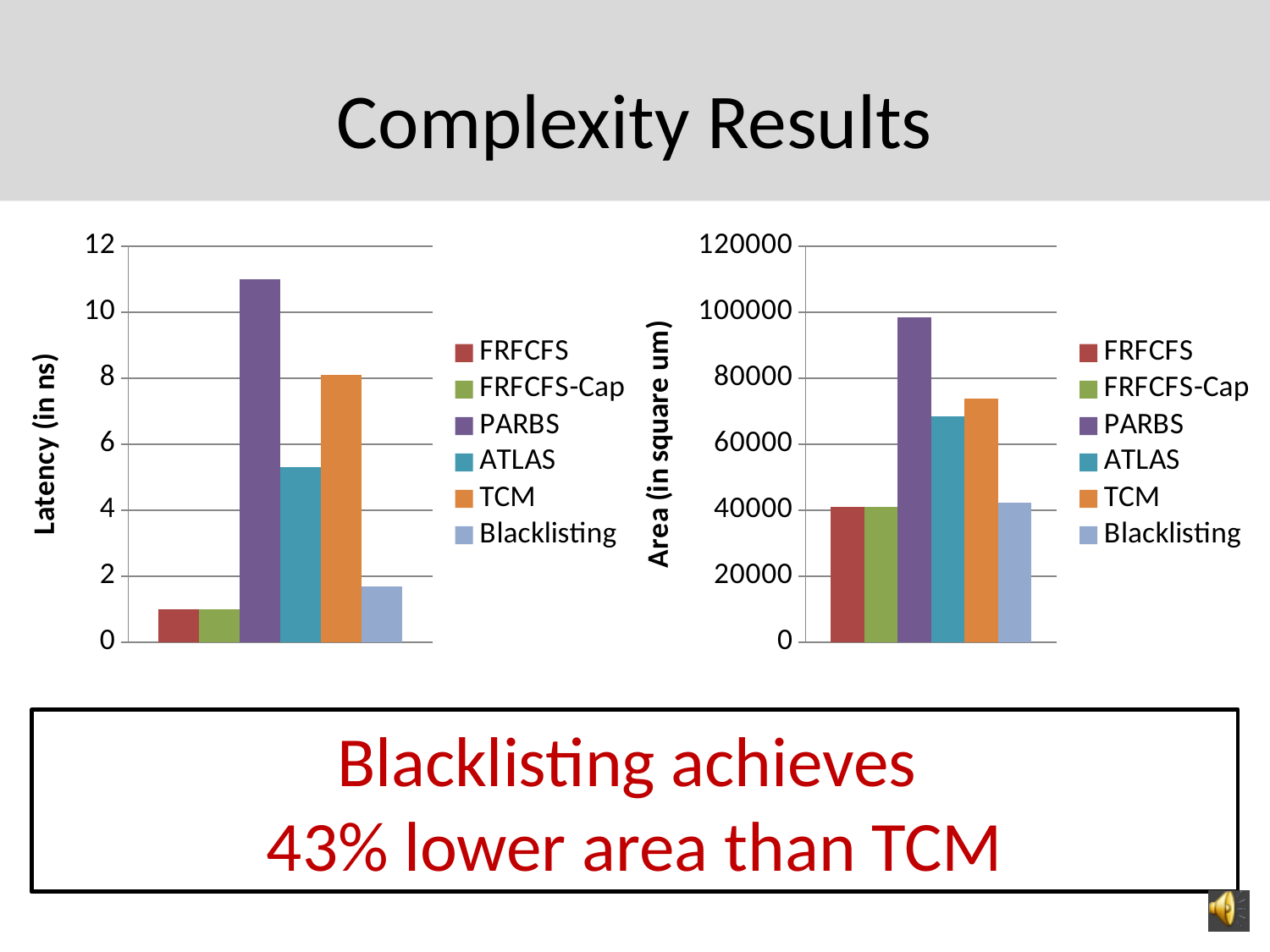
In the right chart (Area in square um), which has the larger area, TCM or ATLAS? TCM How many series does the legend of the right chart (Area in square um) list? 6 In the right chart (Area in square um), which series has the largest area? PARBS In the left chart (Latency in ns), which series has the highest latency? PARBS In the left chart (Latency in ns), is the value for PARBS greater or less than 10? greater In the left chart (Latency in ns), which has the higher latency, Blacklisting or ATLAS? ATLAS In the right chart (Area in square um), is the value for Blacklisting greater or less than 60000? less In the right chart (Area in square um), is the value for PARBS greater or less than 80000? greater What is the y-axis label of the right chart? Area (in square um) What kind of chart is the left chart (Latency in ns)? bar chart In the left chart (Latency in ns), which has the higher latency, TCM or ATLAS? TCM